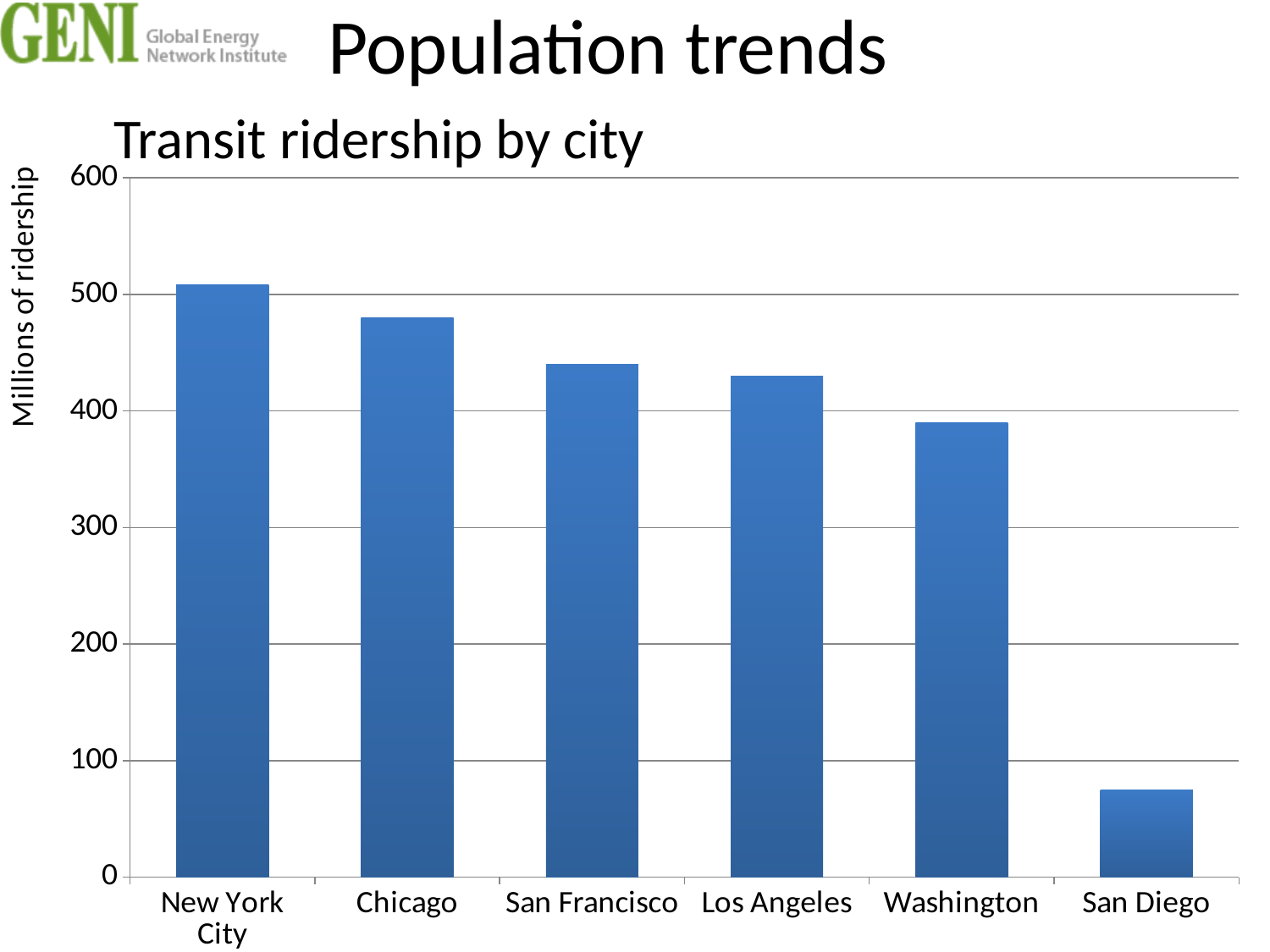
How many cities are shown in the chart? 6 Which city has the highest transit ridership in the chart? New York City Is the value for San Diego greater or less than 100? less What is the title of the chart? Transit ridership by city What type of chart is shown on the slide? bar chart What is the label on the vertical axis of the chart? Millions of ridership Which city has the lowest transit ridership in the chart? San Diego Which has a higher transit ridership, New York City or Chicago? New York City Is the value for New York City greater or less than 500? greater Is the value for Chicago greater or less than 500? less Do the values generally rise or fall moving from left to right across the cities? fall